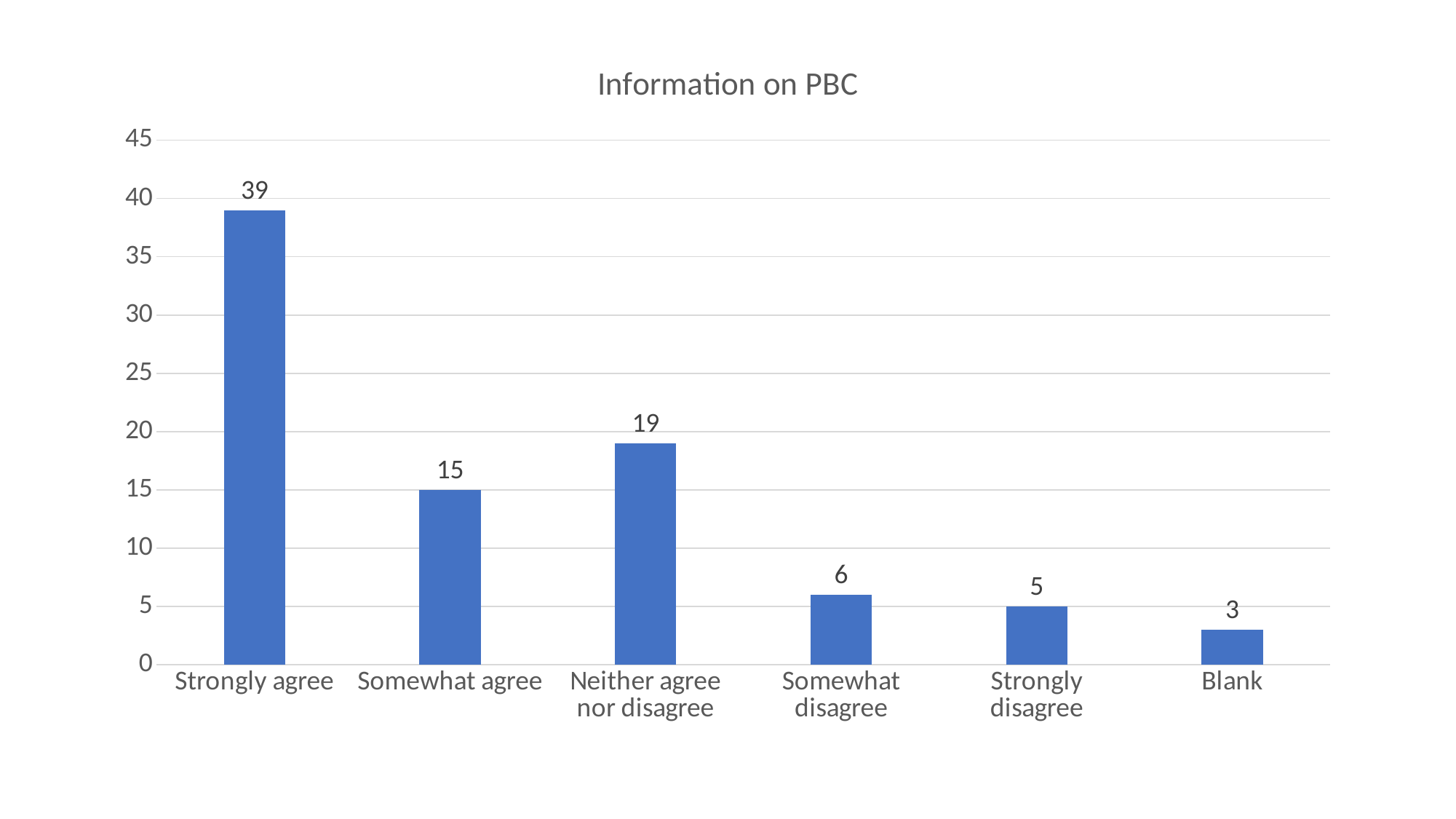
Which is larger, the value for Somewhat agree or the value for Neither agree nor disagree? Neither agree nor disagree Which category has the highest value? Strongly agree Is the value for Somewhat disagree greater or less than 10? less What kind of chart is shown on the slide? bar chart What is the value for Blank? 3 What is the difference between the values for Strongly agree and Somewhat agree? 24 What is the difference between the values for Strongly disagree and Blank? 2 What is the value for Neither agree nor disagree? 19 How many categories are shown on the x axis? 6 What is the title of the chart? Information on PBC What is the value for Strongly agree? 39 Which category has the lowest value? Blank